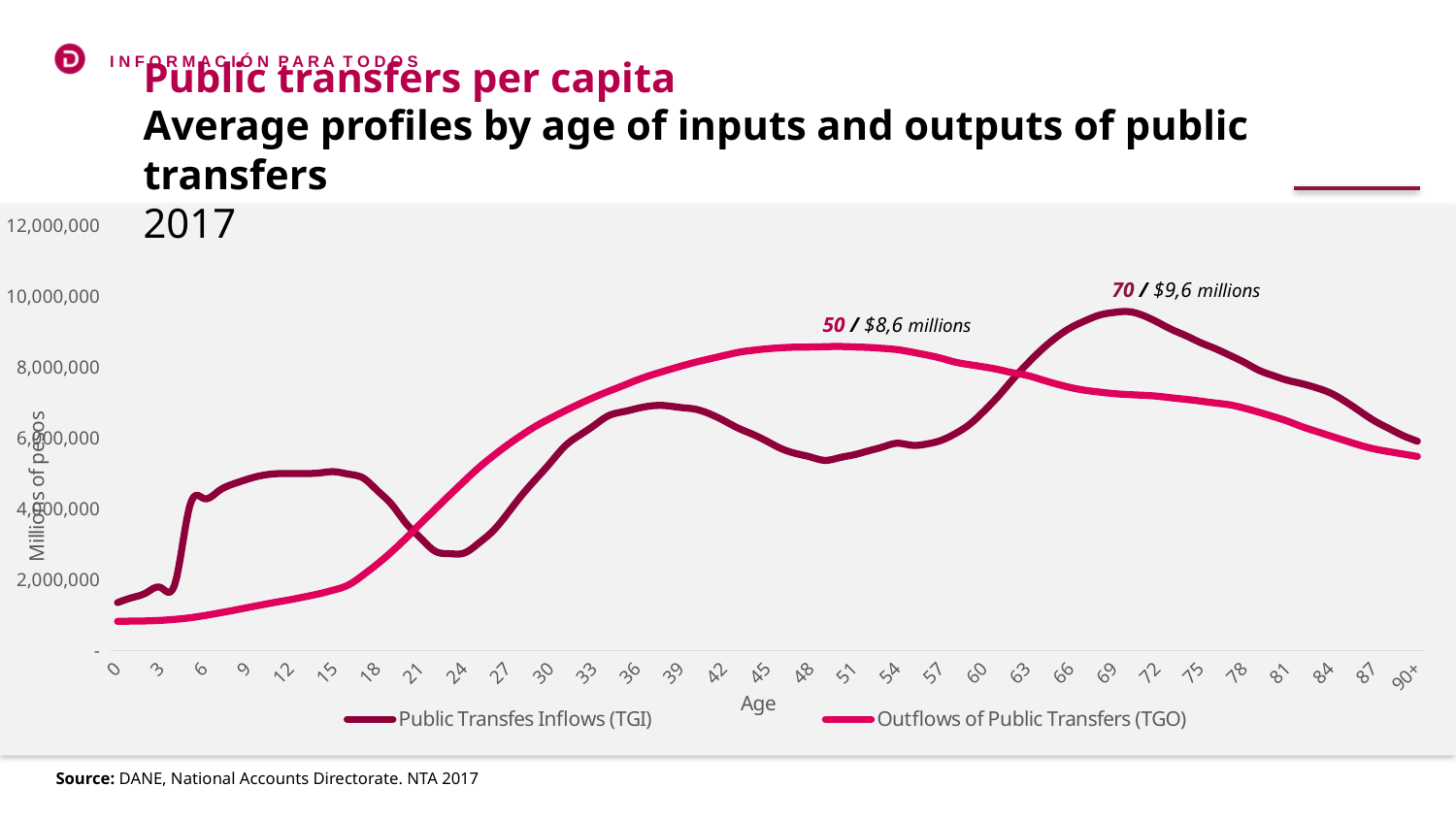
Does the Outflows of Public Transfers (TGO) line rise or fall between age 0 and age 50? rise How many series does the legend list? 2 According to the annotation, what is the peak value of Public Transfers Inflows (TGI), and at what age does it occur? $9,6 millions at age 70 What are the two series named in the legend? Public Transfes Inflows (TGI) and Outflows of Public Transfers (TGO) Is the value of Outflows of Public Transfers (TGO) at age 0 greater or less than 2,000,000? less At age 9, which series has the higher value, Public Transfers Inflows (TGI) or Outflows of Public Transfers (TGO)? Public Transfes Inflows (TGI) Is the value of Public Transfers Inflows (TGI) at age 24 greater or less than 4,000,000? less Which series reaches the higher peak value, Public Transfers Inflows (TGI) or Outflows of Public Transfers (TGO)? Public Transfes Inflows (TGI) According to the annotation, what is the peak value of Outflows of Public Transfers (TGO), and at what age does it occur? $8,6 millions at age 50 At age 24, which series has the higher value, Public Transfers Inflows (TGI) or Outflows of Public Transfers (TGO)? Outflows of Public Transfers (TGO) Is the value of Public Transfers Inflows (TGI) at age 69 greater or less than 8,000,000? greater What kind of chart is shown on the slide? line chart